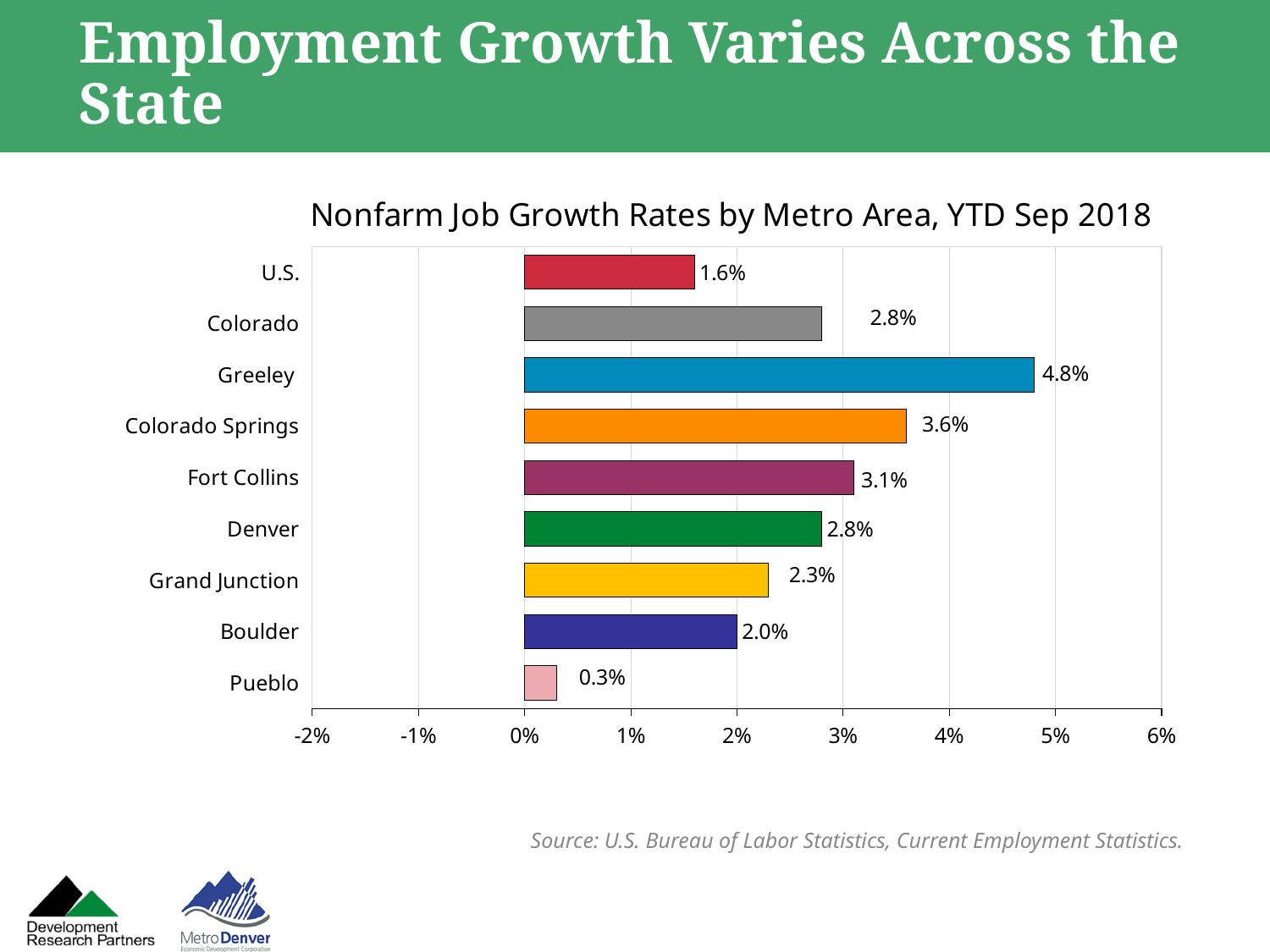
What is the title of the chart? Nonfarm Job Growth Rates by Metro Area, YTD Sep 2018 Which metro area has the highest nonfarm job growth rate? Greeley Which has a higher job growth rate, Fort Collins or Boulder? Fort Collins What is the nonfarm job growth rate for Pueblo? 0.3% What kind of chart is shown on the slide? Bar chart What is the nonfarm job growth rate for Greeley? 4.8% What is the difference between the job growth rates of Greeley and Colorado Springs? 1.2% What is the nonfarm job growth rate for the U.S.? 1.6% How many categories are shown in the chart? 9 Which metro area has the lowest nonfarm job growth rate? Pueblo Is the value for Colorado Springs greater or less than 3%? greater What is the difference between the job growth rates of Colorado and the U.S.? 1.2%